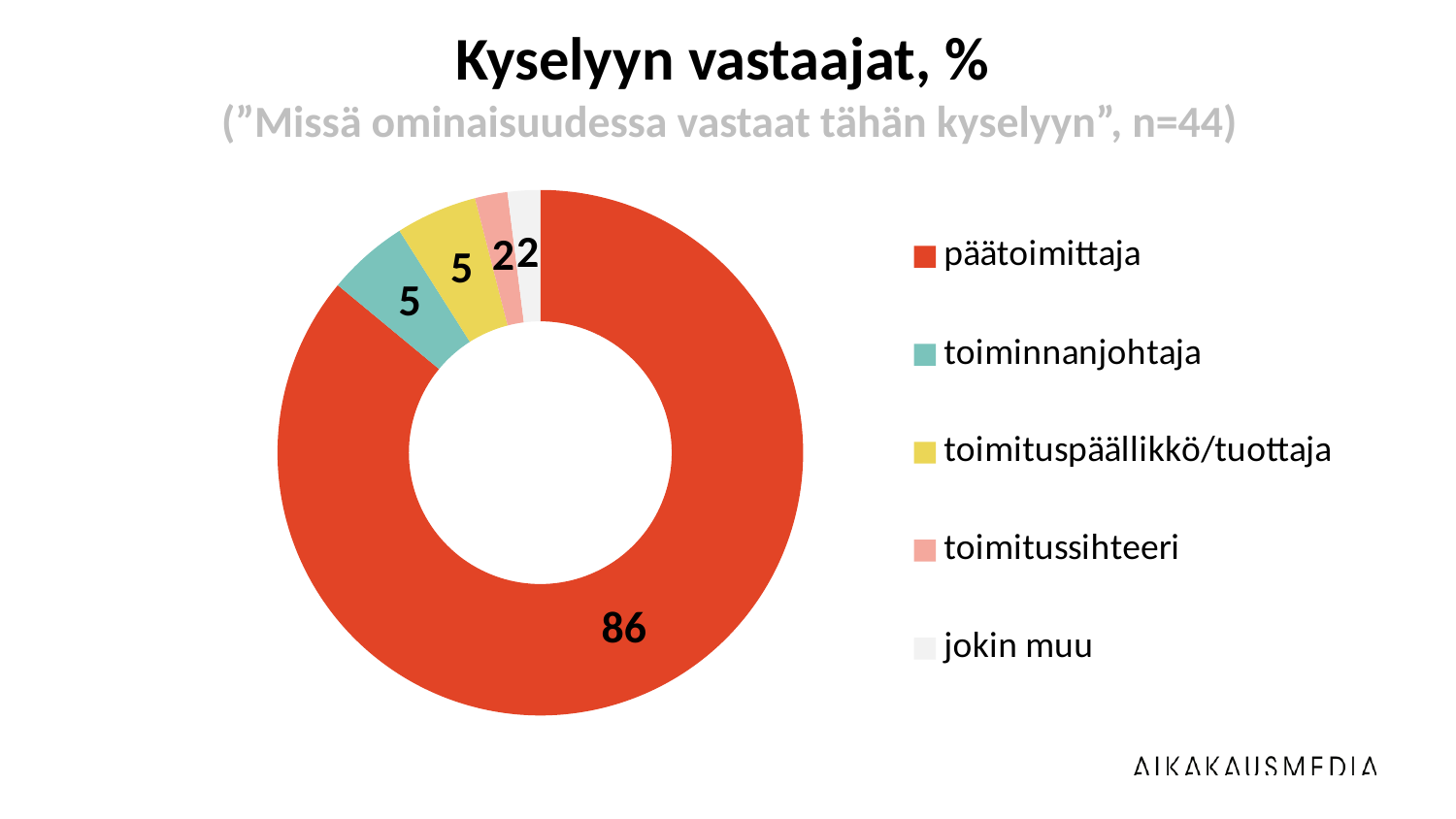
What is the difference between the values for päätoimittaja and toimituspäällikkö/tuottaja? 81 What type of chart is shown on the slide? Pie chart (donut) What is the value for toiminnanjohtaja? 5 What is the value for toimitussihteeri? 2 What is the difference between the values for toiminnanjohtaja and toimitussihteeri? 3 What is the title of the chart? Kyselyyn vastaajat, % Which is larger, the value for päätoimittaja or the value for toiminnanjohtaja? päätoimittaja How many categories does the legend list? 5 What is the value for jokin muu? 2 What is the value for päätoimittaja? 86 What is the value for toimituspäällikkö/tuottaja? 5 Which category has the largest slice? päätoimittaja